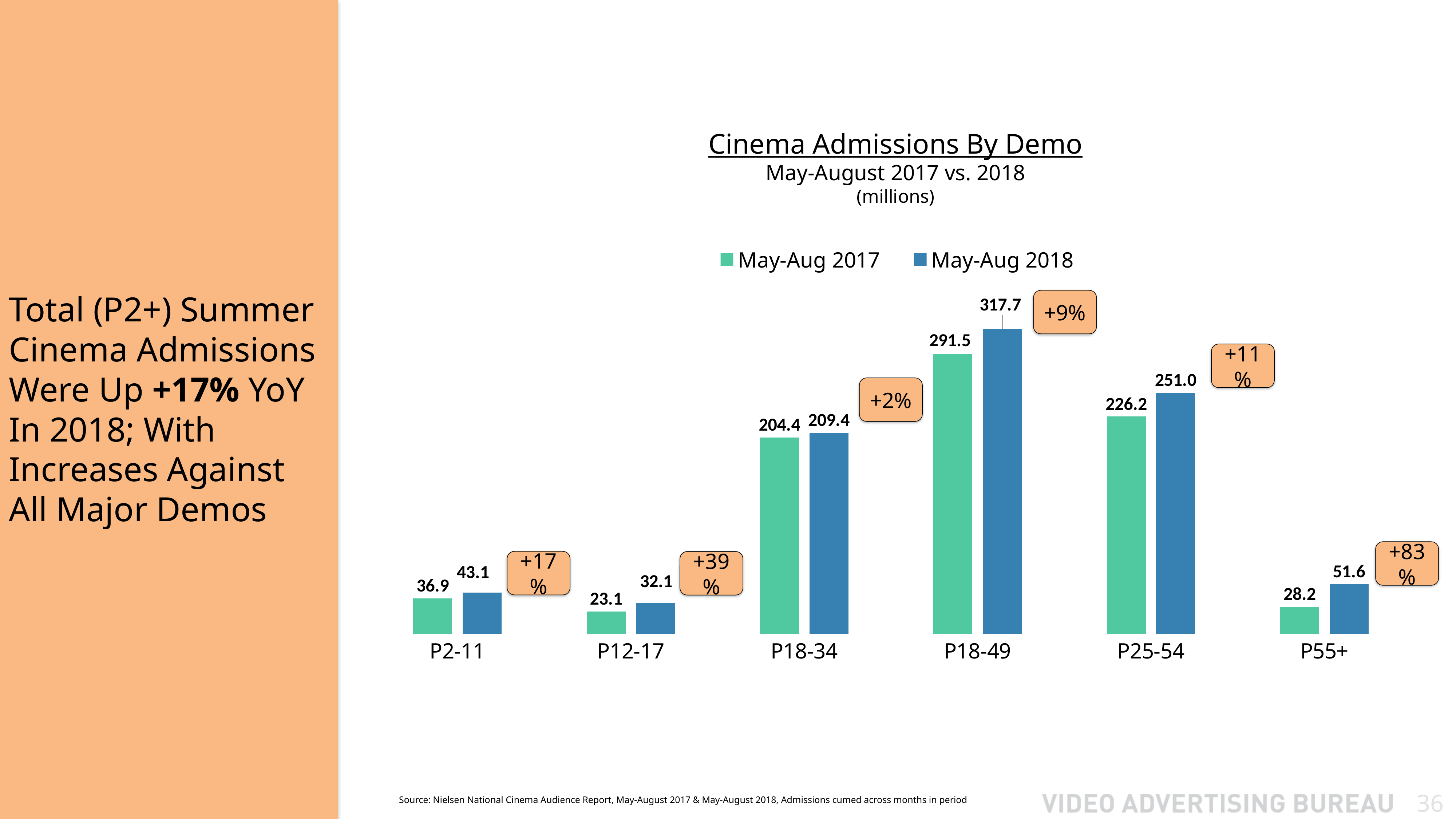
How many demo categories are shown on the x axis? 6 What is the May-Aug 2018 value for P18-49? 317.7 Which demo has the highest May-Aug 2018 value? P18-49 What is the title of the chart? Cinema Admissions By Demo Which demo has the lowest May-Aug 2017 value? P12-17 What is the difference between the May-Aug 2018 and May-Aug 2017 values for P25-54? 24.8 Which is larger: the May-Aug 2017 value for P2-11 or the May-Aug 2017 value for P55+? P2-11 How many series does the legend list? 2 What kind of chart is shown? bar chart What percentage change is shown in the callout for P55+? +83% What is the May-Aug 2017 value for P12-17? 23.1 What is the May-Aug 2018 value for P55+? 51.6